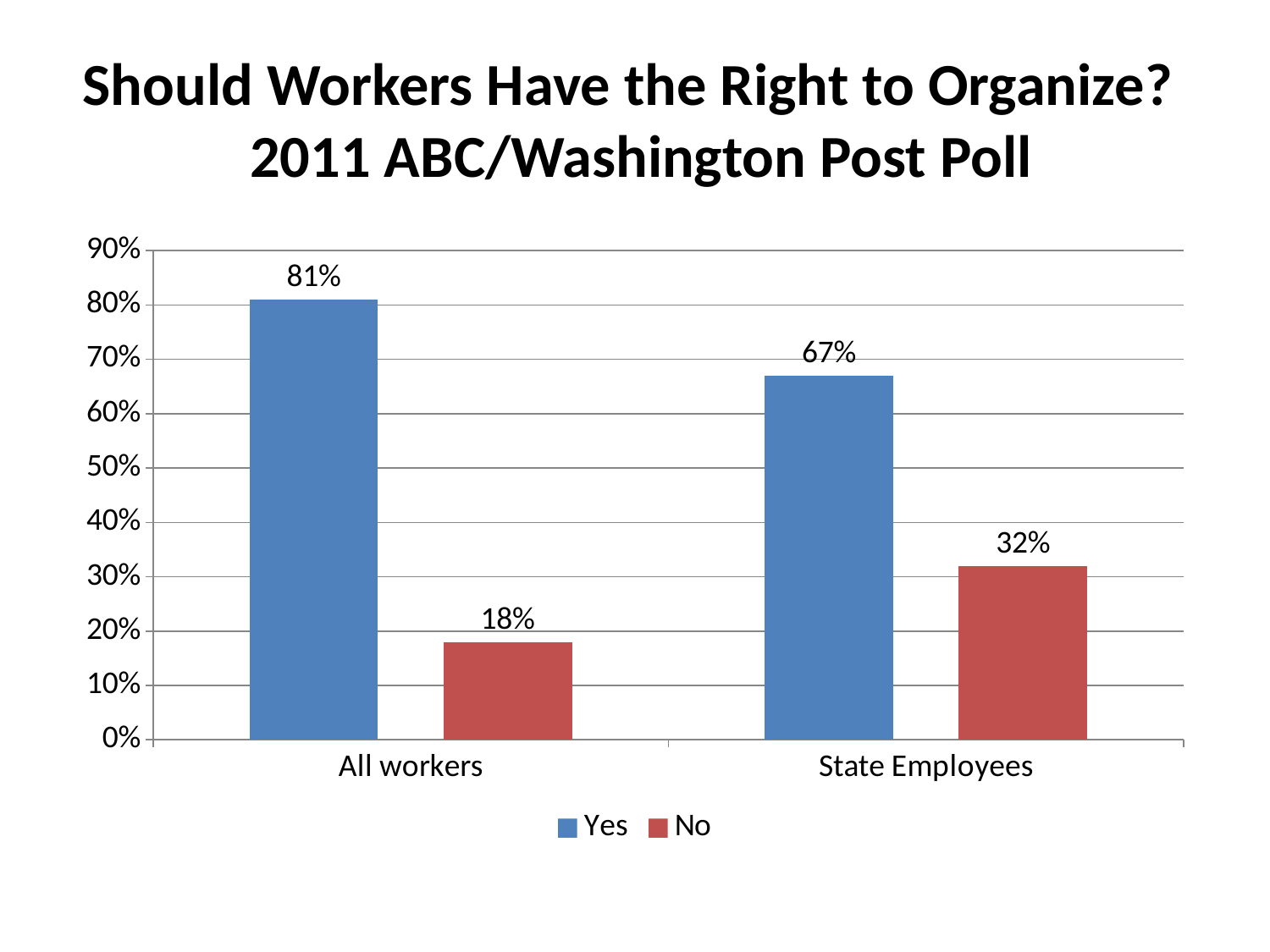
How many series does the legend list? 2 Which bar on the chart is the lowest? No for All workers (18%) Which group has the higher Yes percentage? All workers What percentage of State Employees answered No? 32% What is the difference between the Yes percentages for All workers and State Employees? 14% Is the No percentage for State Employees greater or less than 30%? greater What percentage of State Employees answered Yes? 67% What is the difference between the No percentages for State Employees and All workers? 14% How many groups are shown on the x axis? 2 What kind of chart is shown on the slide? Bar chart What percentage of All workers answered Yes? 81% What percentage of All workers answered No? 18%